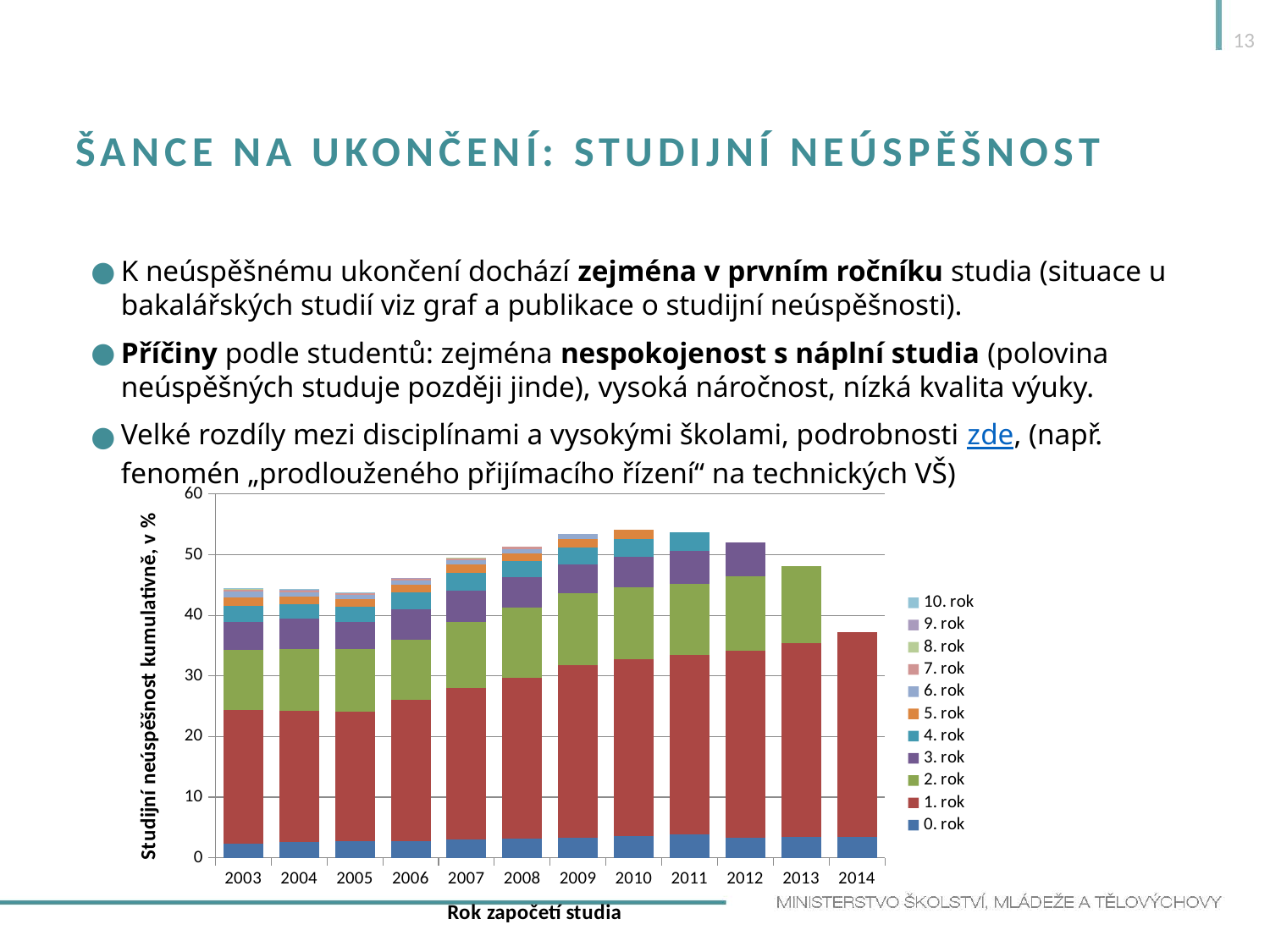
What is the title of the y axis of the chart? Studijní neúspěšnost kumulativně, v % Does the '1. rok' segment generally rise or fall from 2003 to 2014? rise Is the total stacked value for 2013 greater or less than 50? less Is the total stacked value for 2014 greater or less than 40? less How many years (categories) are shown on the x axis of the chart? 12 Which year has the larger total stacked bar, 2012 or 2013? 2012 Is the '1. rok' segment for 2003 greater or less than 30? less Which year has the lowest total stacked bar in the chart? 2014 What kind of chart is shown on the slide? stacked bar chart How many series does the chart's legend list? 11 What is the title of the x axis of the chart? Rok započetí studia